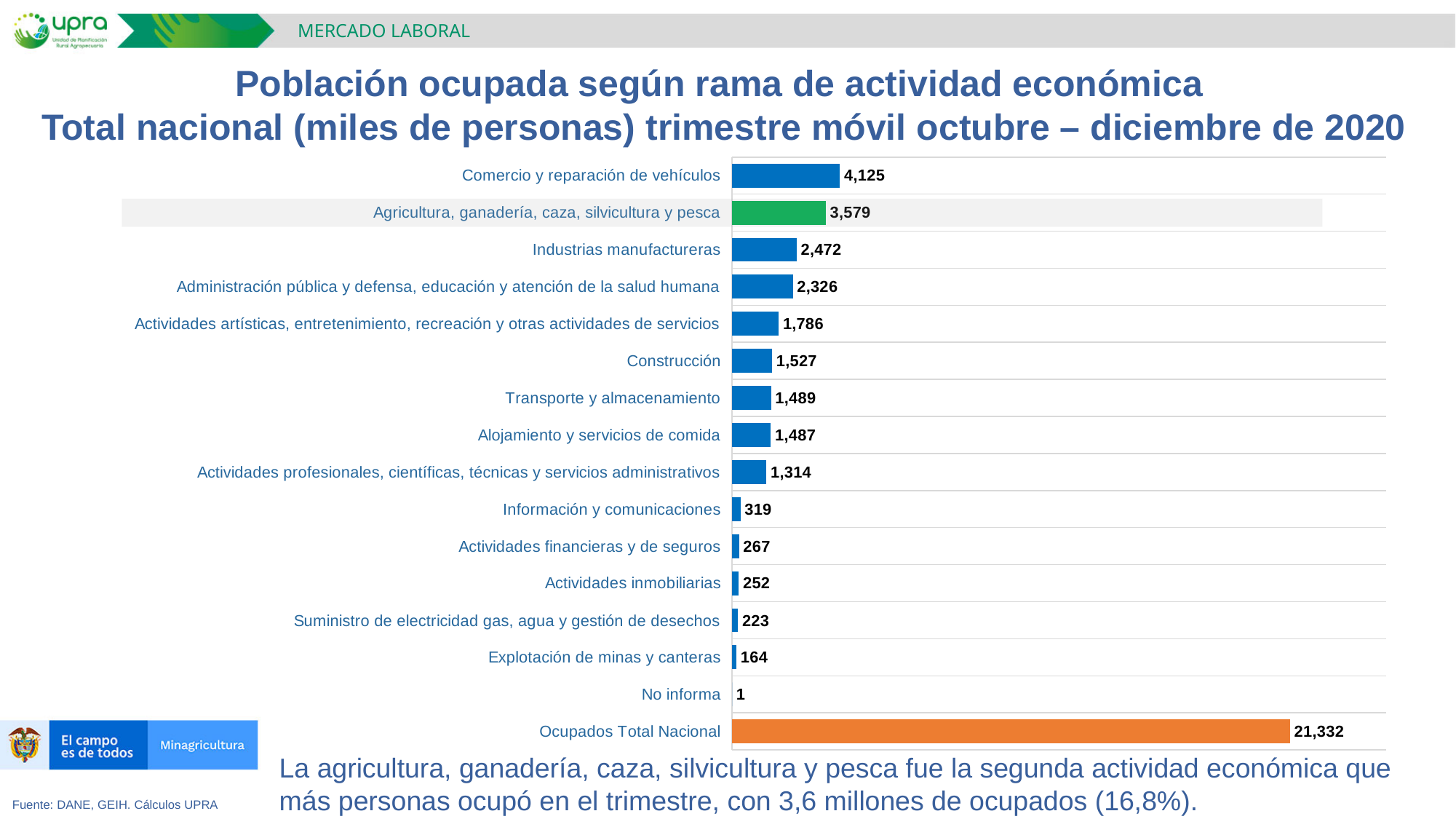
What is the value for Explotación de minas y canteras? 164 What is the value shown for Ocupados Total Nacional? 21,332 What is the value for Comercio y reparación de vehículos? 4,125 Which is larger: Industrias manufactureras or Construcción? Industrias manufactureras Which bar is coloured green? Agricultura, ganadería, caza, silvicultura y pesca What type of chart is shown on the slide? Bar chart What is the difference between Comercio y reparación de vehículos and Agricultura, ganadería, caza, silvicultura y pesca? 546 How many categories are shown in the chart? 16 Which category has the lowest value? No informa Excluding the Ocupados Total Nacional bar, which economic activity has the highest value? Comercio y reparación de vehículos What is the value for Agricultura, ganadería, caza, silvicultura y pesca? 3,579 What is the difference between Información y comunicaciones and Actividades financieras y de seguros? 52